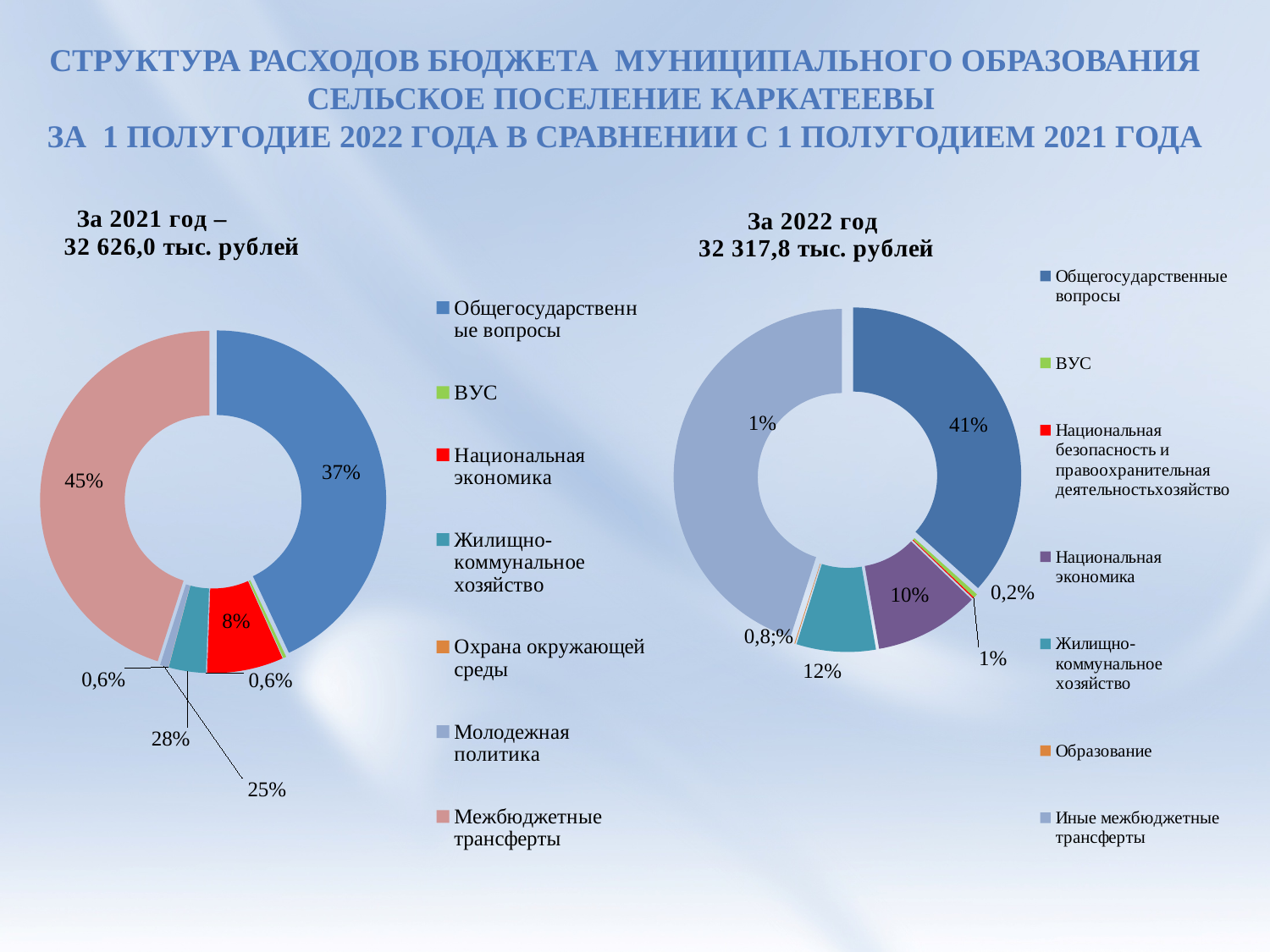
How many categories does the legend of the right chart (За 2022 год) list? 7 In the right chart (За 2022 год), what share is shown for Общегосударственные вопросы? 41% In the left chart (За 2021 год), how many percentage points larger is Межбюджетные трансферты than Общегосударственные вопросы? 8 percentage points In the right chart (За 2022 год), what share is shown for Жилищно-коммунальное хозяйство? 12% What type of chart is used on this slide? Doughnut (pie) chart In the right chart (За 2022 год), what share is shown for Национальная экономика? 10% In the right chart (За 2022 год), which category has the largest share? Иные межбюджетные трансферты In the left chart (За 2021 год), which category has the largest share? Межбюджетные трансферты In the left chart (За 2021 год), what share is shown for Национальная экономика? 8% Which is larger: the share of Общегосударственные вопросы in the 2021 chart or in the 2022 chart? 2022 chart (41%) In the left chart (За 2021 год), what share is shown for Общегосударственные вопросы? 37% In the left chart (За 2021 год), what share is shown for Межбюджетные трансферты? 45%